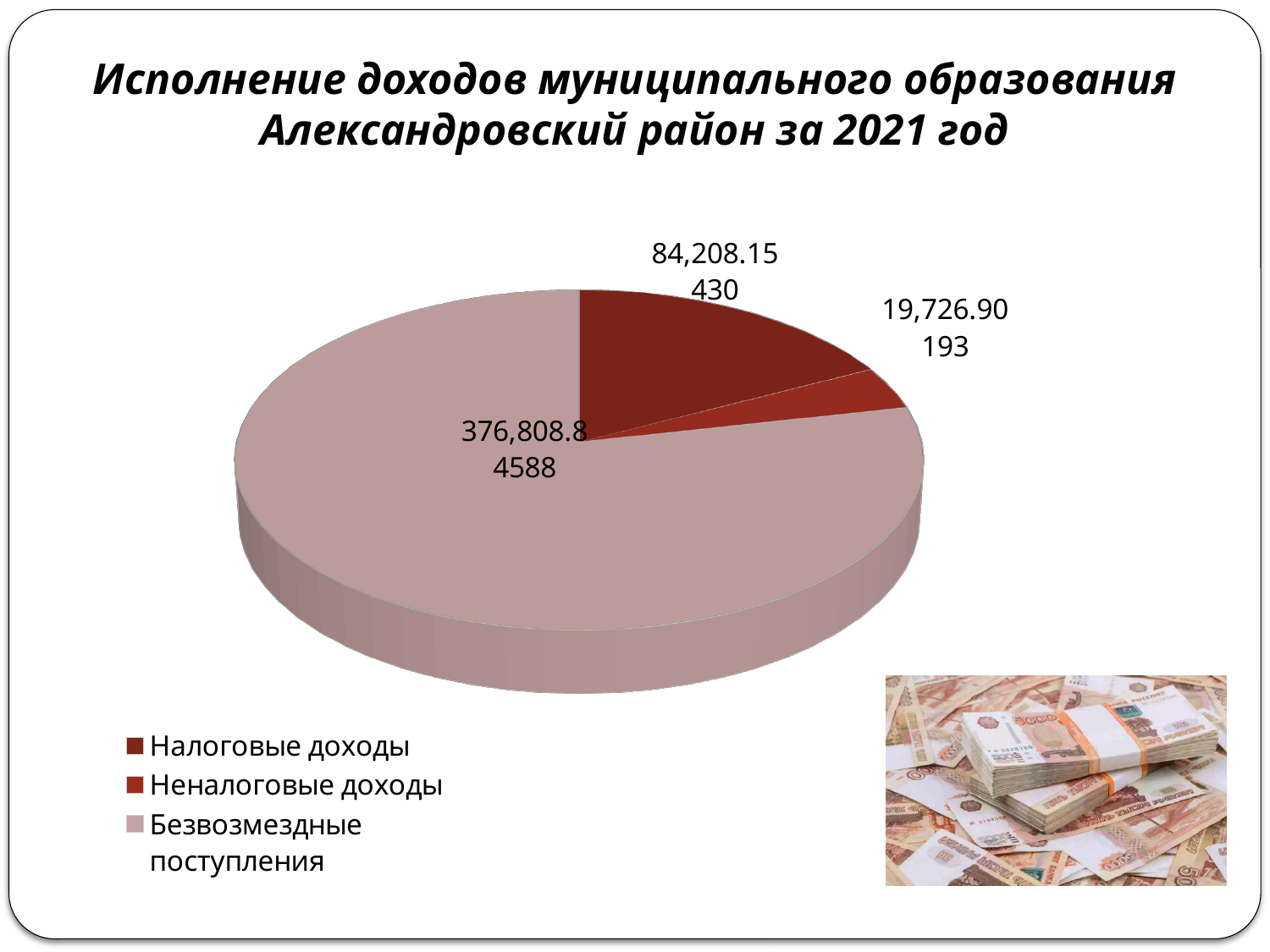
What kind of chart is shown on the slide? pie chart Which category has the largest slice of the pie? Безвозмездные поступления Which category has the smallest slice of the pie? Неналоговые доходы What value is labelled on the Налоговые доходы slice? 84,208.15430 What is the title of the slide? Исполнение доходов муниципального образования Александровский район за 2021 год How many slices does the pie chart have? 3 What value is labelled on the Безвозмездные поступления slice? 376,808.84588 Which is larger, Налоговые доходы or Неналоговые доходы? Налоговые доходы What value is labelled on the Неналоговые доходы slice? 19,726.90193 Which is larger, Безвозмездные поступления or Налоговые доходы? Безвозмездные поступления How many entries does the legend list? 3 Which legend entry is shown in the lightest (pale pink) colour? Безвозмездные поступления